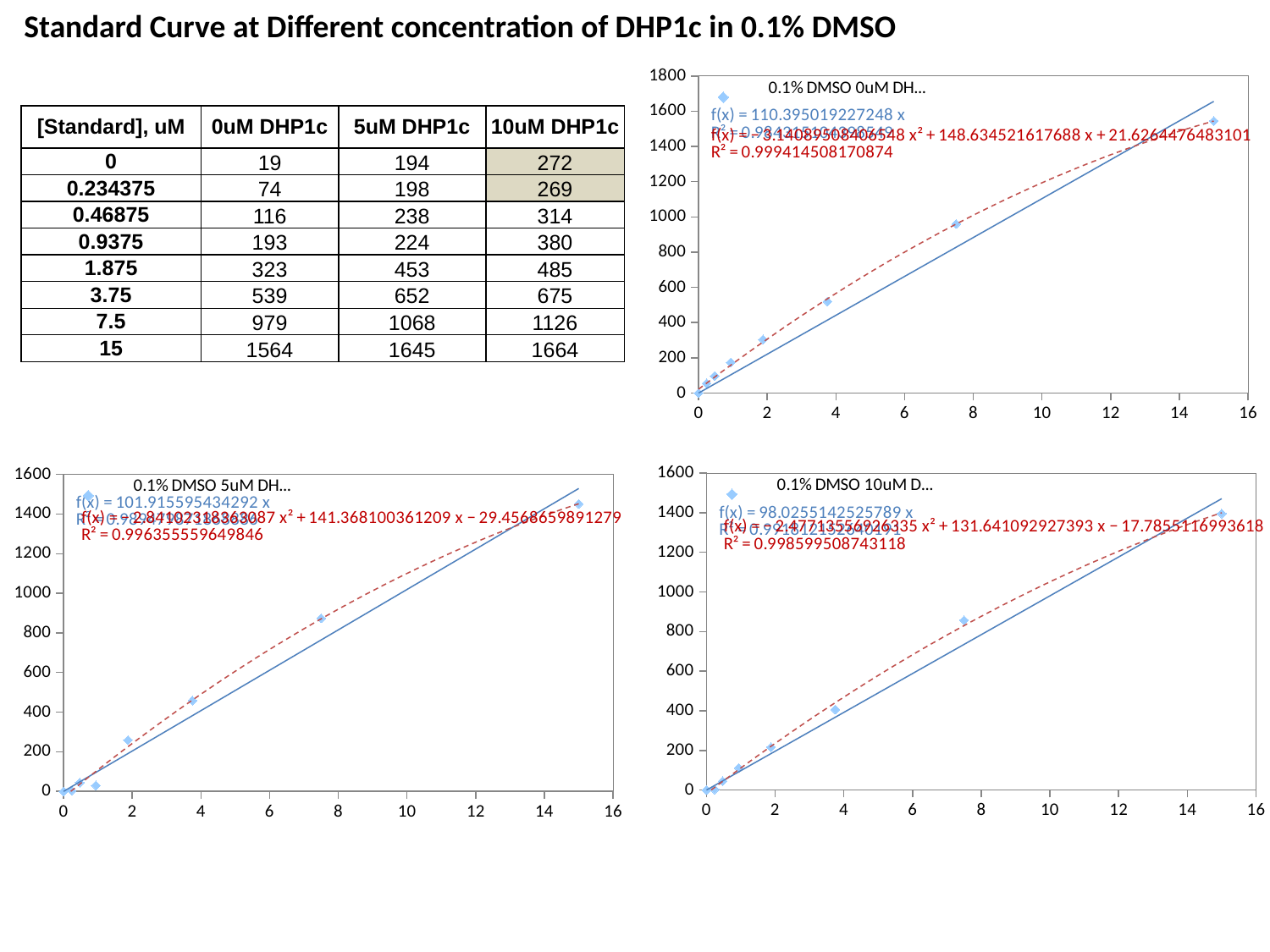
In the bottom-right chart (0.1% DMSO 10uM D...), do the plotted values rise or fall as x increases? rise What kind of chart is the top-right chart titled '0.1% DMSO 0uM DH...'? scatter chart In the top-right chart (0.1% DMSO 0uM DH...), is the plotted value at x = 7.5 greater or less than 800? greater In the top-right chart (0.1% DMSO 0uM DH...), which plotted point is lower, the one at x = 3.75 or the one at x = 7.5? x = 3.75 In the top-right chart (0.1% DMSO 0uM DH...), is the plotted value at x = 15 greater or less than 1400? greater In the bottom-left chart (0.1% DMSO 5uM DH...), is the plotted value at x = 15 greater or less than 1200? greater In the bottom-left chart (0.1% DMSO 5uM DH...), which plotted point has the highest value, the one at x = 7.5 or the one at x = 15? x = 15 What R² value is printed in red for the polynomial fit in the bottom-left chart (0.1% DMSO 5uM DH...)? 0.996355559649846 What is the highest value shown on the y axis of the top-right chart (0.1% DMSO 0uM DH...)? 1800